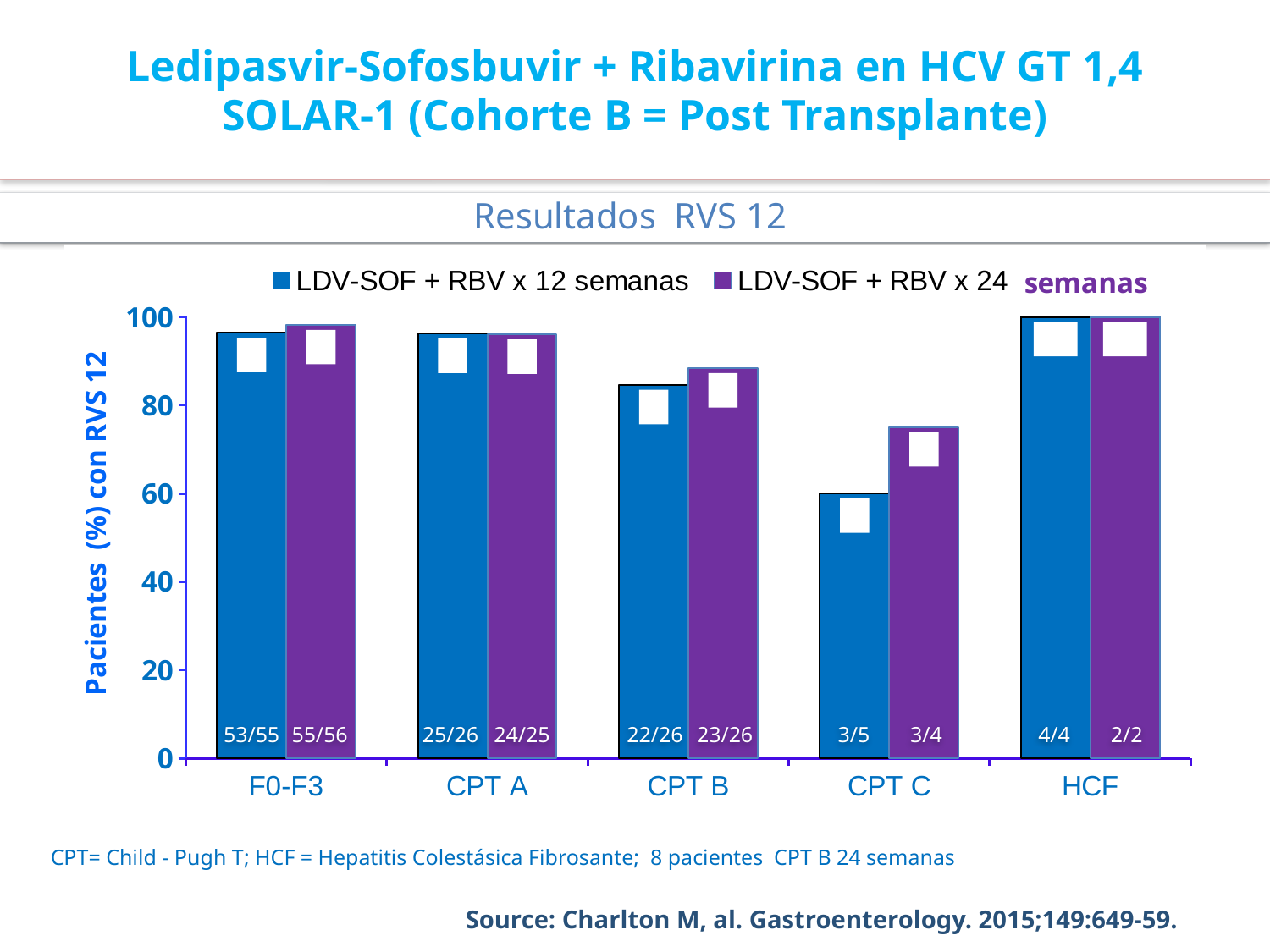
Is the value for CPT C with LDV-SOF + RBV x 12 semanas greater or less than 80? less Is the value for CPT B with LDV-SOF + RBV x 24 semanas greater or less than 80? greater What is the title of the y axis? Pacientes (%) con RVS 12 Is the value for CPT C with LDV-SOF + RBV x 24 semanas greater or less than 60? greater Which category has the lowest bar for LDV-SOF + RBV x 12 semanas? CPT C What kind of chart is shown on the slide? bar chart What label is printed on the LDV-SOF + RBV x 24 semanas bar for F0-F3? 55/56 For CPT C, which is larger: the 12-week bar or the 24-week bar? the 24-week bar What label is printed on the LDV-SOF + RBV x 24 semanas bar for HCF? 2/2 How many patient categories are shown on the x axis? 5 How many series does the legend list? 2 What label is printed on the LDV-SOF + RBV x 12 semanas bar for CPT C? 3/5